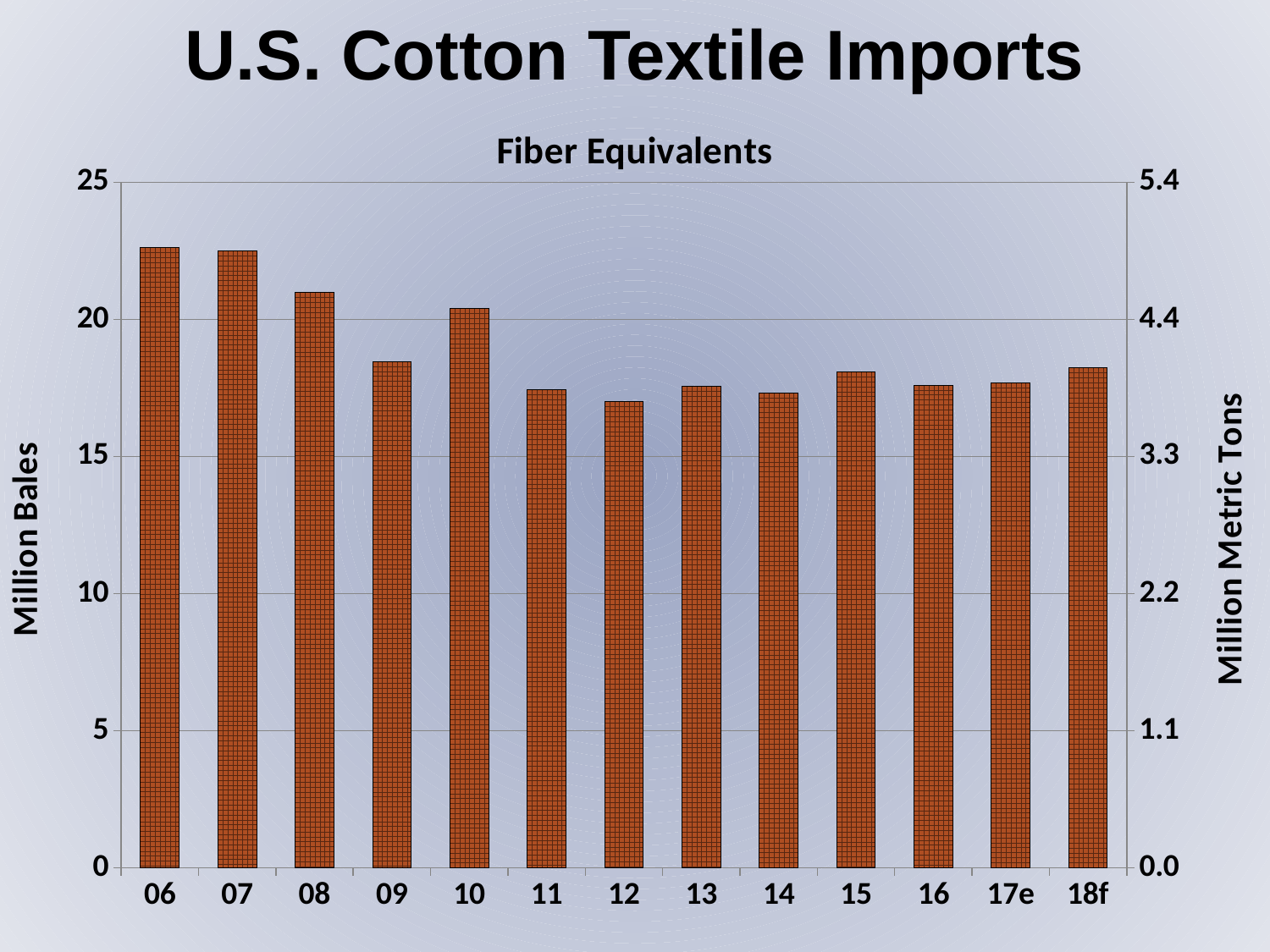
What is the label of the right-hand vertical axis? Million Metric Tons Which is larger, the value for 10 or the value for 11? 10 Which year has the lowest value? 12 What is the title shown above the chart's plot area? Fiber Equivalents How many years (categories) are plotted on the x axis? 13 Is the value for 12 greater or less than 15 million bales? greater Do the values generally rise or fall from 06 to 12? fall Is the value for 06 greater or less than 20 million bales? greater Is the value for 09 greater or less than 20 million bales? less Which is larger, the value for 08 or the value for 09? 08 What kind of chart is shown on the slide? bar chart